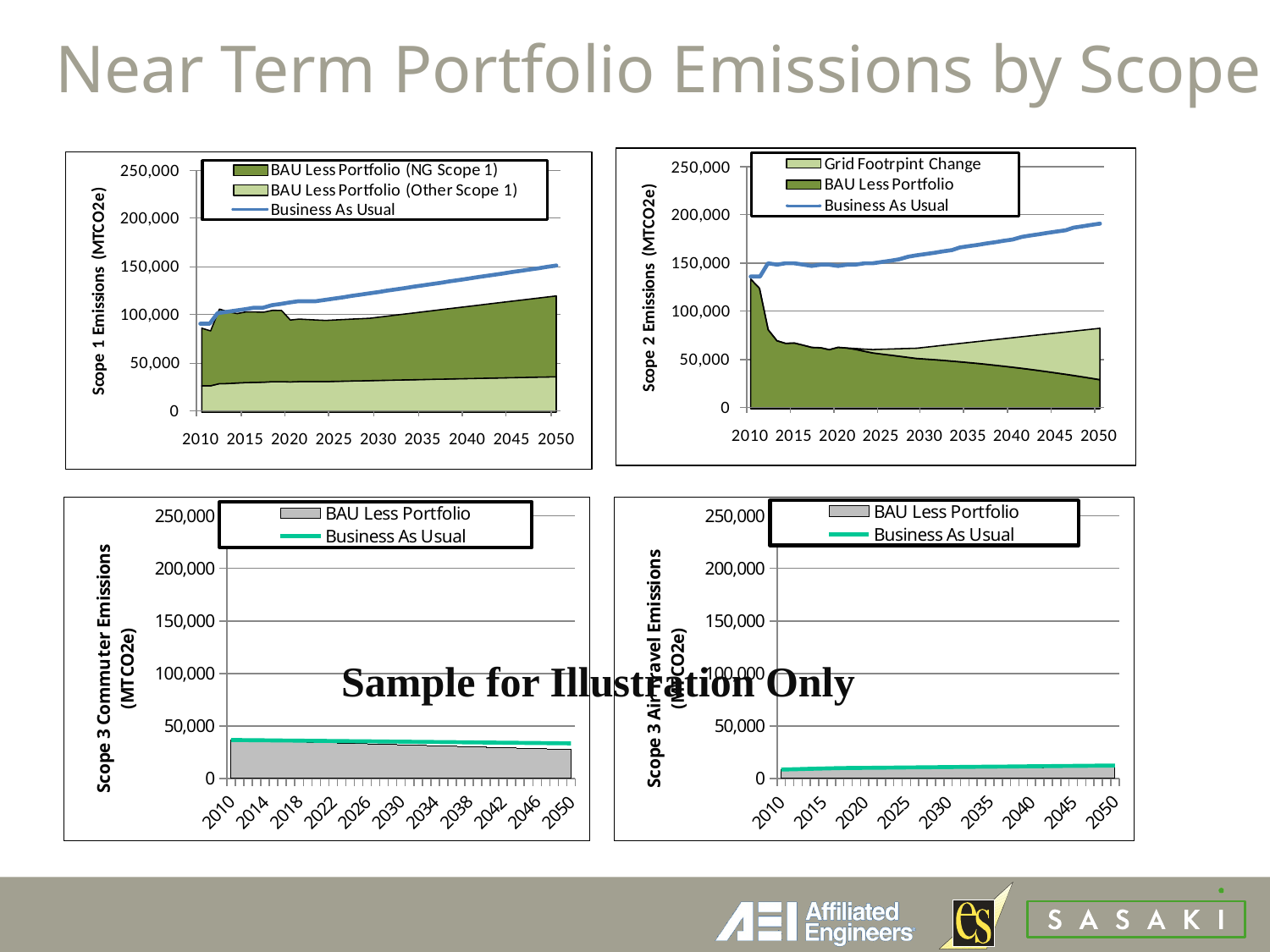
In the Scope 3 Air Travel Emissions chart (bottom right), how many series does the legend list? 2 In the Scope 2 Emissions chart (top right), does the Business As Usual line rise or fall from 2015 to 2050? rise In the Scope 3 Commuter Emissions chart (bottom left), is the Business As Usual value in 2010 greater or less than 50,000? less How many charts are shown on the slide? 4 In the Scope 1 Emissions chart (top left), does the Business As Usual line rise or fall from 2010 to 2050? rise In the Scope 1 Emissions chart (top left), is the Business As Usual value in 2050 greater or less than 100,000? greater In the Scope 2 Emissions chart (top right), is the Business As Usual value in 2050 greater or less than 150,000? greater In the Scope 1 Emissions chart (top left), how many series does the legend list? 3 In the Scope 3 Commuter Emissions chart (bottom left), how many series does the legend list? 2 In the Scope 2 Emissions chart (top right), which legend entry is shown in the lightest green? Grid Footrpint Change